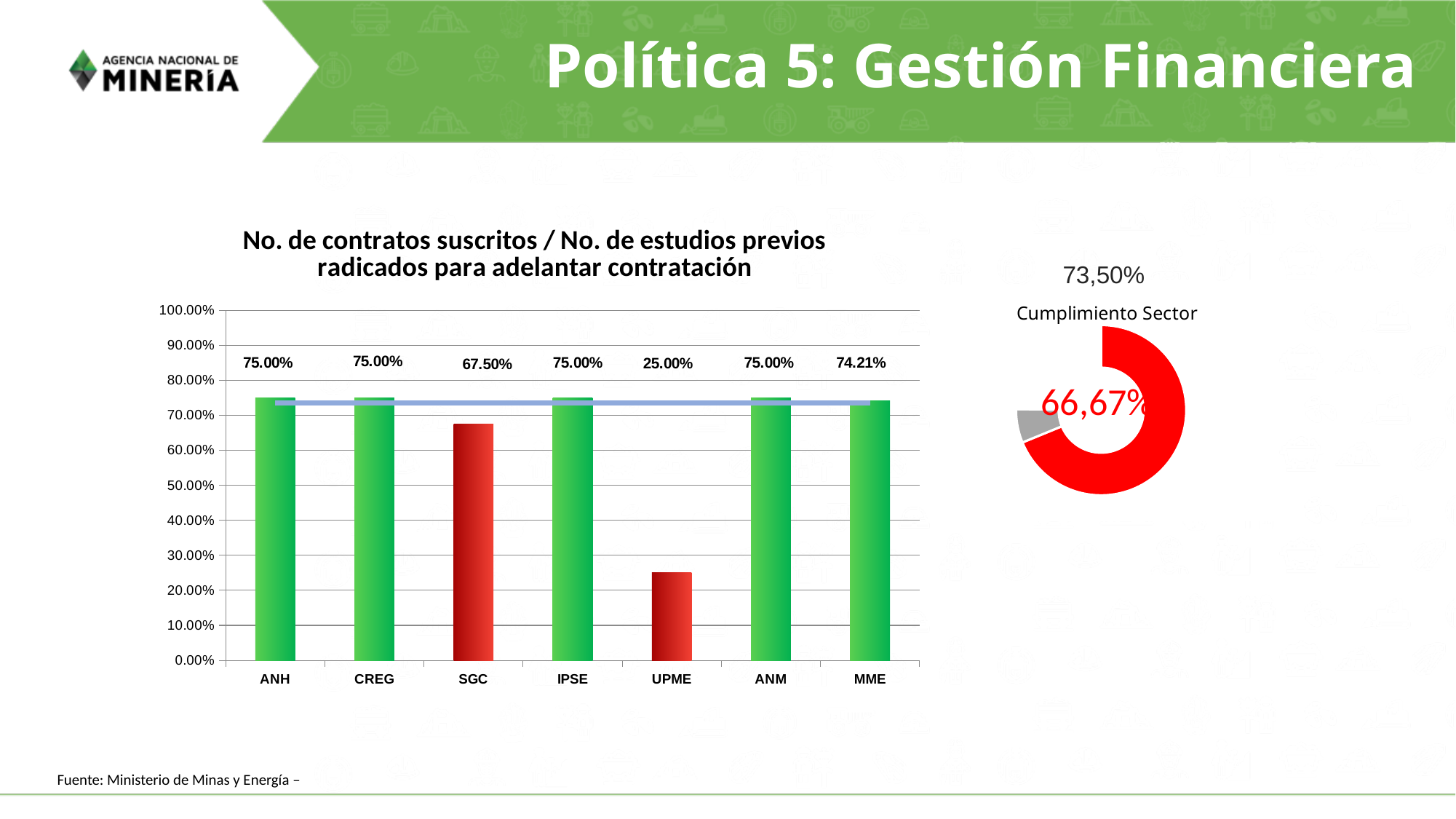
What kind of chart is the chart titled 'No. de contratos suscritos / No. de estudios previos radicados para adelantar contratación'? combination bar and line chart In the bar chart 'No. de contratos suscritos / No. de estudios previos radicados para adelantar contratación', how many bars are coloured red? 2 What percentage is printed inside the doughnut chart labelled 'Cumplimiento Sector' on the right of the slide? 66,67% In the bar chart 'No. de contratos suscritos / No. de estudios previos radicados para adelantar contratación', what is the value for MME? 74.21% In the bar chart 'No. de contratos suscritos / No. de estudios previos radicados para adelantar contratación', what is the value for SGC? 67.50% In the bar chart 'No. de contratos suscritos / No. de estudios previos radicados para adelantar contratación', which is larger, the value for SGC or the value for UPME? SGC In the bar chart 'No. de contratos suscritos / No. de estudios previos radicados para adelantar contratación', is the value for UPME greater or less than 30.00%? less How many categories are shown on the x axis of the bar chart 'No. de contratos suscritos / No. de estudios previos radicados para adelantar contratación'? 7 In the bar chart 'No. de contratos suscritos / No. de estudios previos radicados para adelantar contratación', what is the value for UPME? 25.00% In the bar chart 'No. de contratos suscritos / No. de estudios previos radicados para adelantar contratación', what is the difference between the values for SGC and MME? 6.71% In the bar chart 'No. de contratos suscritos / No. de estudios previos radicados para adelantar contratación', what is the difference between the values for ANH and UPME? 50.00% In the bar chart 'No. de contratos suscritos / No. de estudios previos radicados para adelantar contratación', which category has the lowest value? UPME